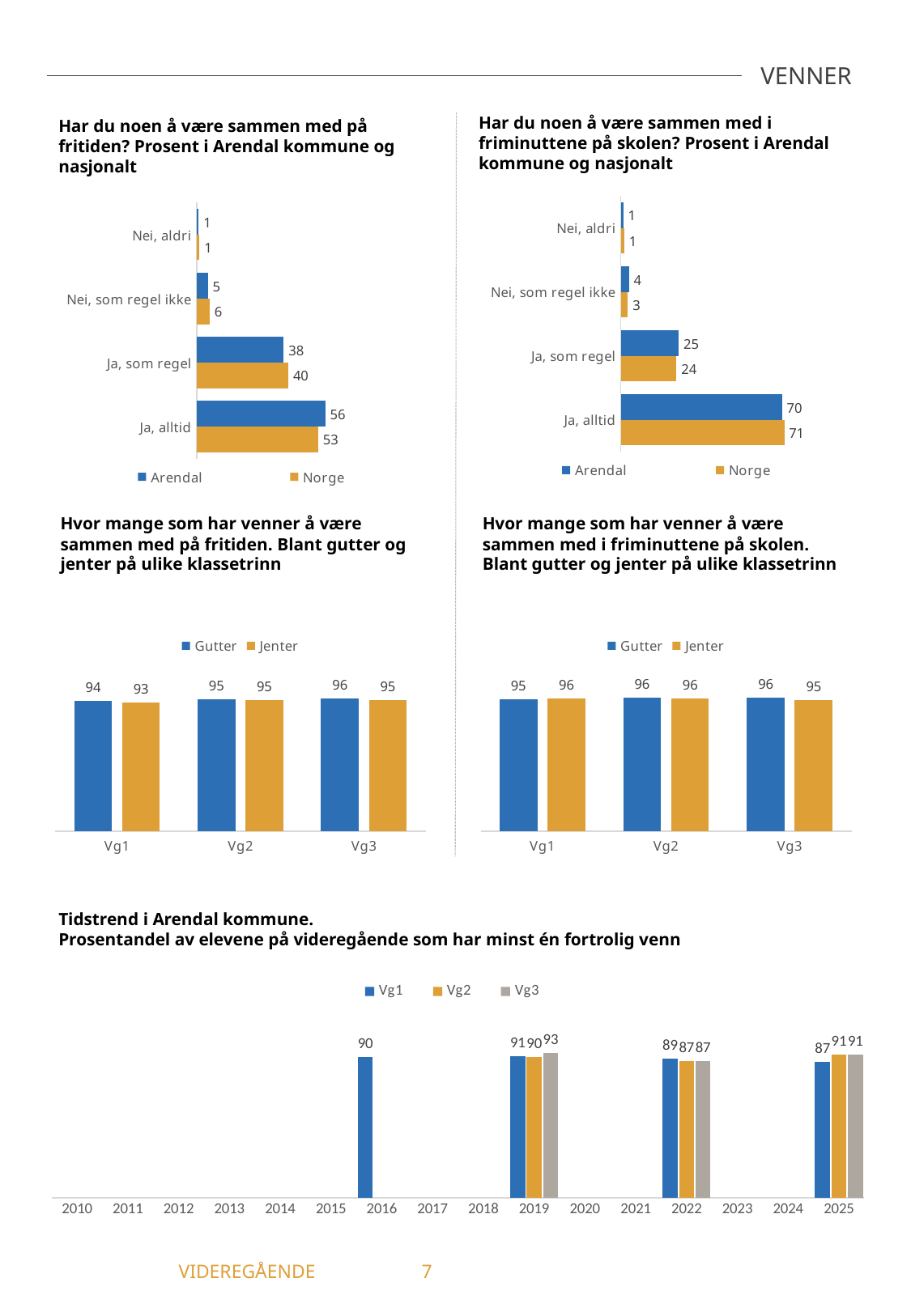
In the middle-right chart 'Hvor mange som har venner å være sammen med i friminuttene på skolen', what is the Jenter value for Vg3? 95 In the middle-left chart 'Hvor mange som har venner å være sammen med på fritiden', what is the Gutter value for Vg1? 94 In the middle-left chart 'Hvor mange som har venner å være sammen med på fritiden', how many class levels are shown on the x axis? 3 In the top-left chart 'Har du noen å være sammen med på fritiden?', what is the Arendal value for 'Ja, alltid'? 56 In the top-left chart 'Har du noen å være sammen med på fritiden?', what is the difference between the Norge and Arendal values for 'Ja, som regel'? 2 In the middle-right chart 'Hvor mange som har venner å være sammen med i friminuttene på skolen', which is larger for Vg1: Gutter or Jenter? Jenter What kind of chart is the bottom chart 'Tidstrend i Arendal kommune'? Bar chart In the bottom chart 'Tidstrend i Arendal kommune', what is the Vg3 value for 2019? 93 In the top-right chart 'Har du noen å være sammen med i friminuttene på skolen?', what is the Norge value for 'Ja, alltid'? 71 In the bottom chart 'Tidstrend i Arendal kommune', what is the difference between the Vg1 values for 2016 and 2025? 3 In the top-right chart 'Har du noen å være sammen med i friminuttene på skolen?', how many series does the legend list? 2 In the top-right chart 'Har du noen å være sammen med i friminuttene på skolen?', which category has the highest Arendal value? Ja, alltid